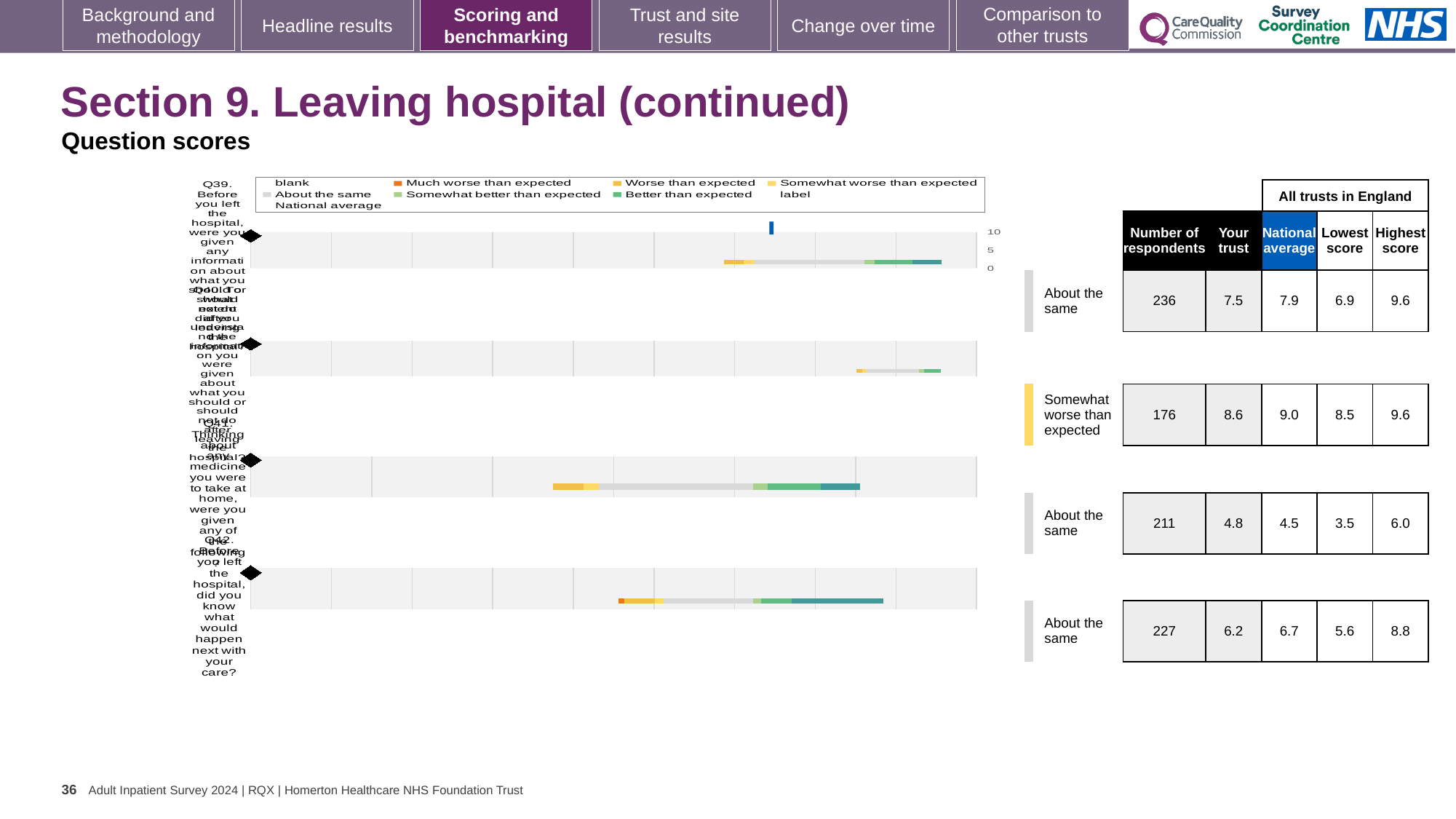
What is the highest score across all trusts in England for Q42? 8.8 How many questions (rows) are plotted in the chart? 4 What is the national average score for Q39? 7.9 How many respondents answered Q41? 211 Which question has the lowest 'Your trust' score? Q41 What kind of chart is shown on the slide? bar chart For Q41, is the 'Your trust' score or the national average larger? Your trust What is the difference between the national average and the 'Your trust' score for Q40? 0.4 Which colour in the legend represents 'Much worse than expected'? orange What benchmark category is Q40 placed in? Somewhat worse than expected Which question has the highest 'Your trust' score? Q40 What is the 'Your trust' score for Q39 in the table beside the chart? 7.5